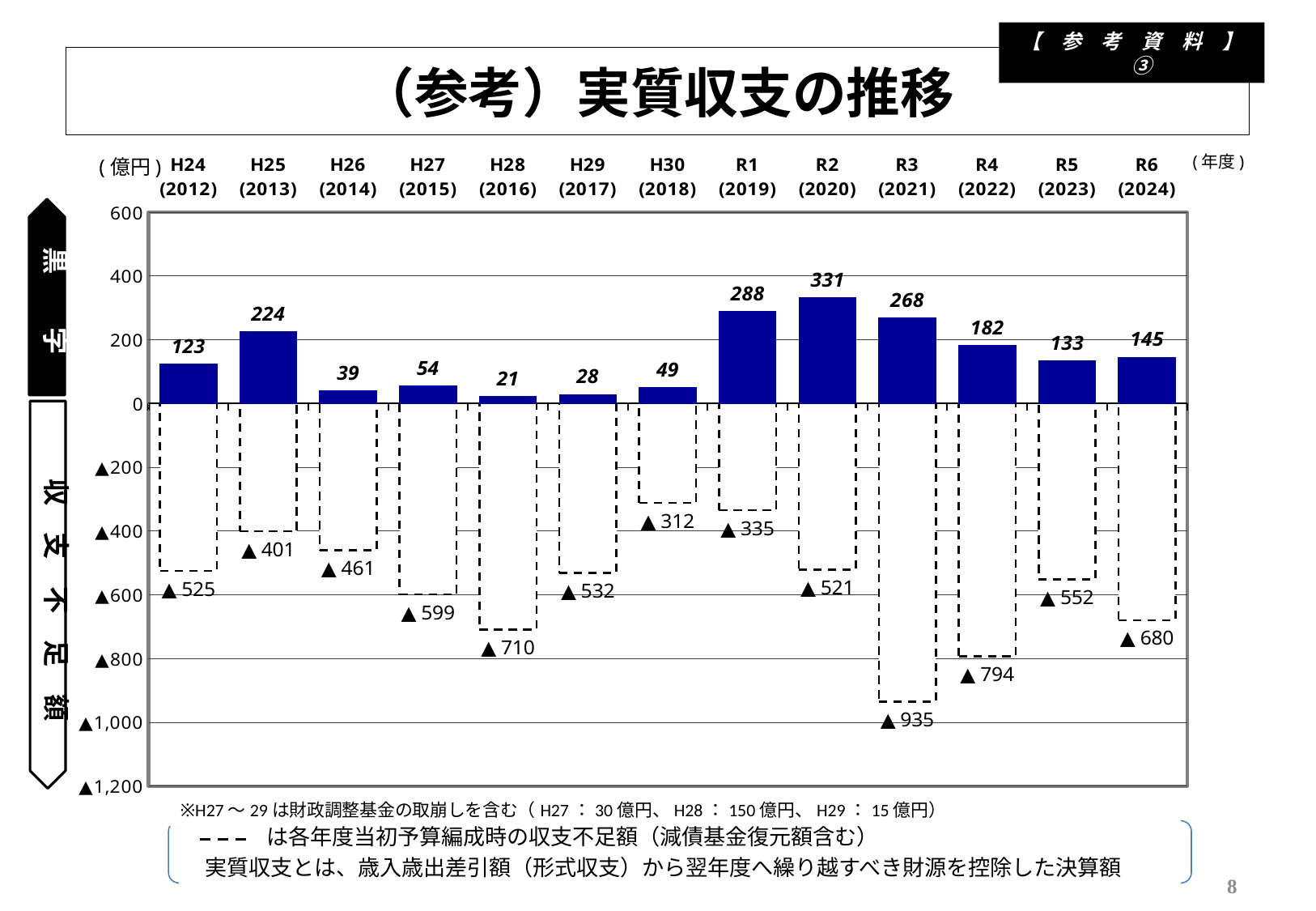
What is the dashed-box 収支不足額 value shown for H30 (2018)? ▲312 Which fiscal year has the lowest 実質収支 (blue bar)? H28 (2016) What is the unit shown at the top left of the chart's vertical axis? 億円 What kind of chart is used to show the 実質収支 values? bar chart What is the 実質収支 (blue bar) value for R2 (2020)? 331 What is the difference between the 実質収支 values for R1 (2019) and R6 (2024)? 143 How many fiscal years are shown on the x axis of the chart? 13 Which is larger, the 実質収支 for H25 (2013) or for R4 (2022)? H25 (2013) What is the dashed-box 収支不足額 value shown for R3 (2021)? ▲935 Is the 実質収支 value for R3 (2021) greater or less than 200? greater What is the 実質収支 (blue bar) value for H28 (2016)? 21 Which fiscal year has the highest 実質収支 (blue bar)? R2 (2020)